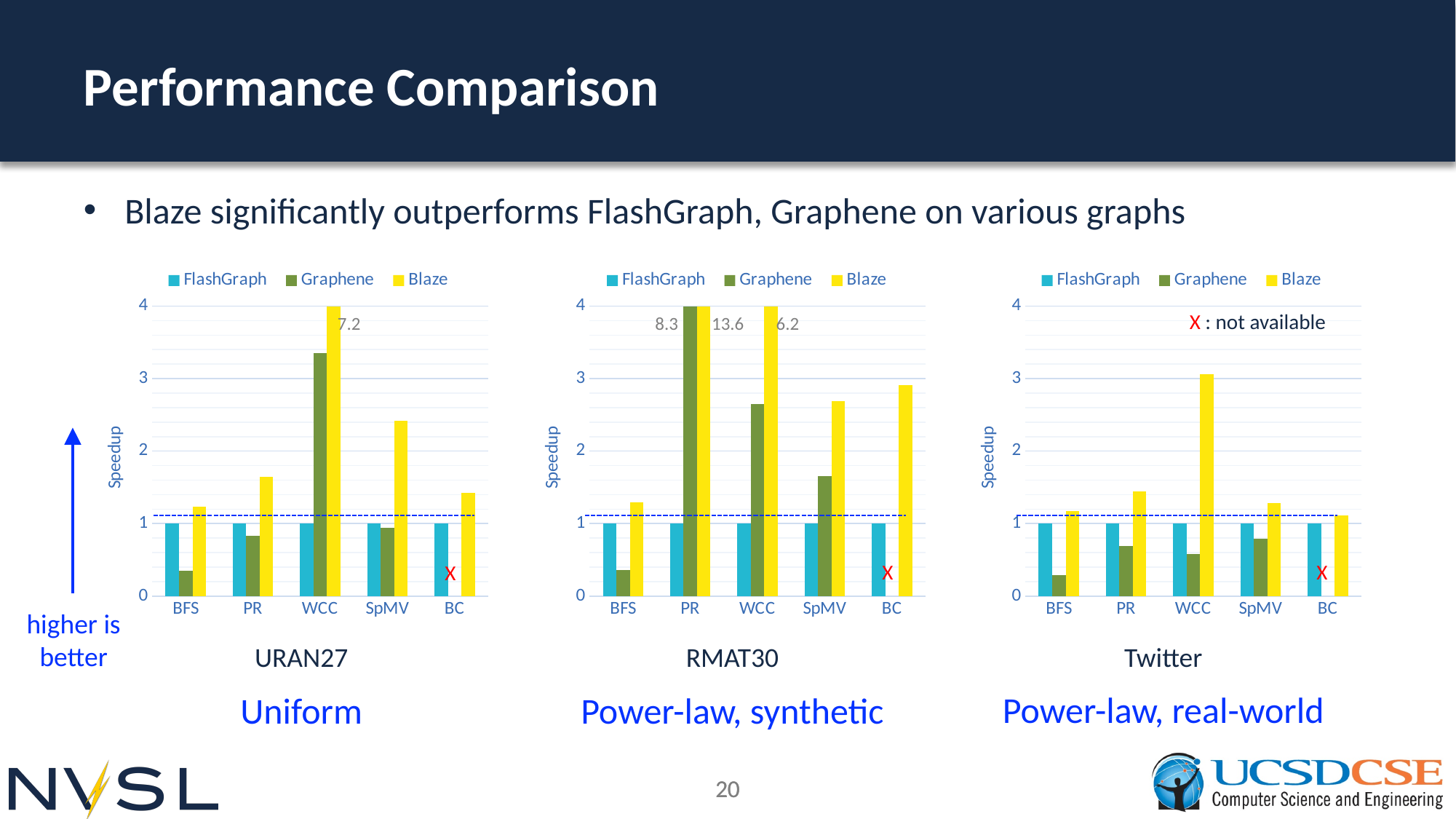
In the Twitter chart, which category has the highest Blaze speedup? WCC In the RMAT30 chart, what is the Blaze speedup for WCC? 6.2 How many series does the legend of the Twitter chart list? 3 In the RMAT30 chart, what is the Graphene speedup for PR? 8.3 In the URAN27 chart, is the Graphene value for BFS greater or less than 1? less In the RMAT30 chart, which is larger for SpMV, the Graphene bar or the Blaze bar? Blaze In the URAN27 chart, what is the Blaze speedup for WCC? 7.2 How many categories are shown on the x axis of the URAN27 chart? 5 In the RMAT30 chart, what is the Blaze speedup for PR? 13.6 In the RMAT30 chart, how much higher is the Blaze speedup for PR than the Graphene speedup for PR? 5.3 What type of chart is the RMAT30 chart? Bar chart